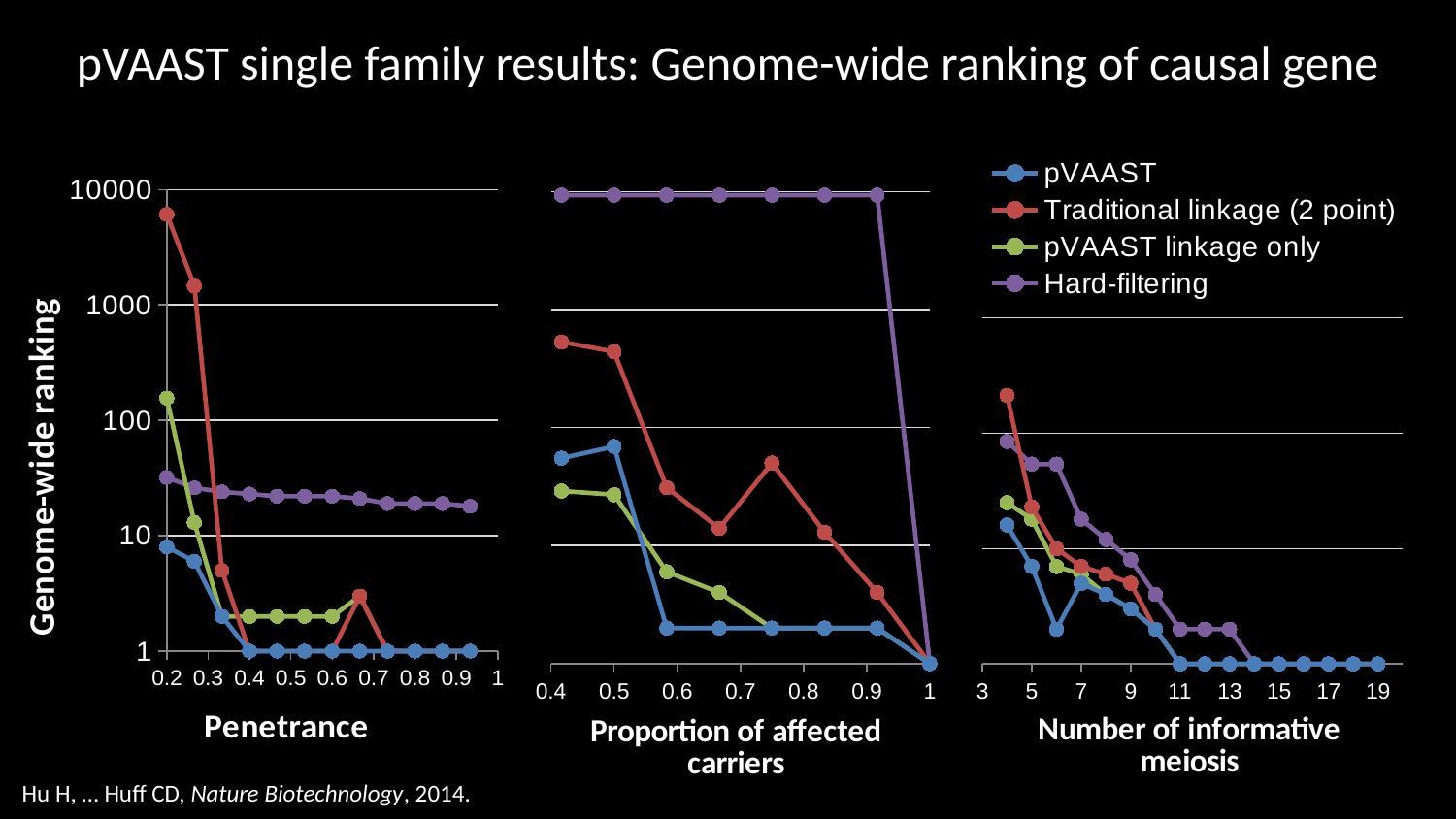
How many charts are on the slide? 3 What kind of charts are shown on the slide? Line charts In the Penetrance chart, is the value for Traditional linkage (2 point) at penetrance 0.2 greater or less than 1000? greater In the Penetrance chart, does the Traditional linkage (2 point) series rise or fall as penetrance increases? Fall In the Number of informative meiosis chart, which is larger at 6 meioses: pVAAST or pVAAST linkage only? pVAAST linkage only In the Penetrance chart, is the value for Hard-filtering at penetrance 0.2 greater or less than 10? greater In the Proportion of affected carriers chart, which is larger at proportion 0.4: Traditional linkage (2 point) or pVAAST? Traditional linkage (2 point) How many series does the legend list? 4 In the Number of informative meiosis chart, is the value for Traditional linkage (2 point) at 4 meioses greater or less than 100? greater In the Proportion of affected carriers chart, which series has the highest value at proportion 0.5? Hard-filtering What is the title of the shared y axis? Genome-wide ranking In the Penetrance chart, which series has the lowest value at penetrance 0.2? pVAAST